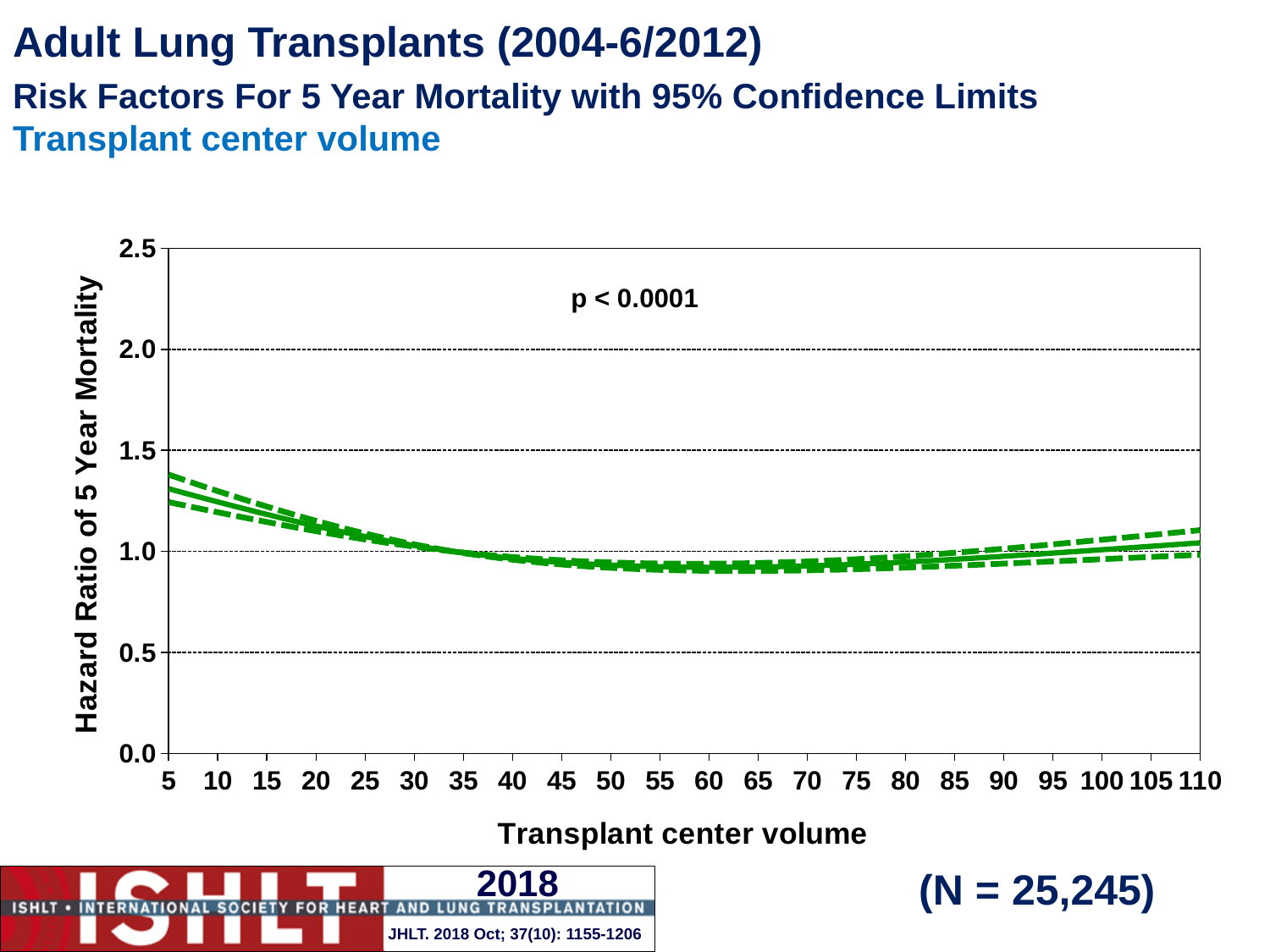
How many tick labels are shown on the x axis? 22 Which has the higher hazard ratio: a transplant center volume of 20 or of 70? 20 Is the hazard ratio at a transplant center volume of 30 greater or less than 0.5? greater Is the hazard ratio at a transplant center volume of 5 greater or less than 1.5? less Does the hazard ratio rise or fall as transplant center volume increases from 80 to 110? rise Is the hazard ratio at a transplant center volume of 5 greater or less than 1.0? greater At which transplant center volume shown on the x axis is the hazard ratio highest? 5 What p-value is printed on the chart? p < 0.0001 What kind of chart is shown on the slide? line chart Which has the higher hazard ratio: a transplant center volume of 5 or of 60? 5 Does the hazard ratio rise or fall as transplant center volume increases from 5 to 55? fall